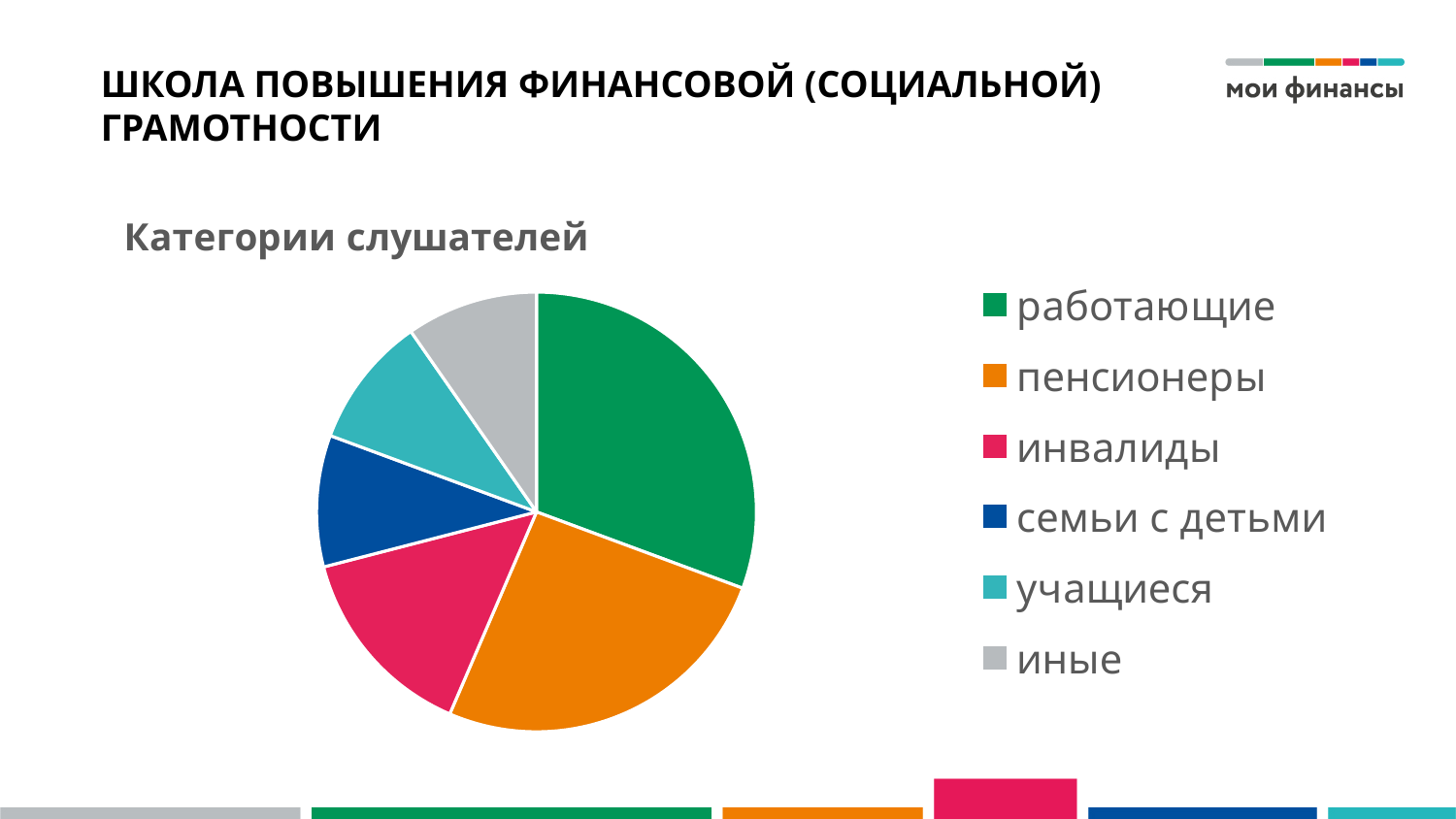
What is the title of the chart? Категории слушателей How many categories does the pie chart have? 6 Which slice is larger, пенсионеры or учащиеся? пенсионеры What kind of chart is shown on the slide? pie chart Which slice is larger, пенсионеры or семьи с детьми? пенсионеры Which category has the largest slice of the pie? работающие What colour is the slice for пенсионеры? orange How many entries does the legend list? 6 Which slice is larger, работающие or инвалиды? работающие